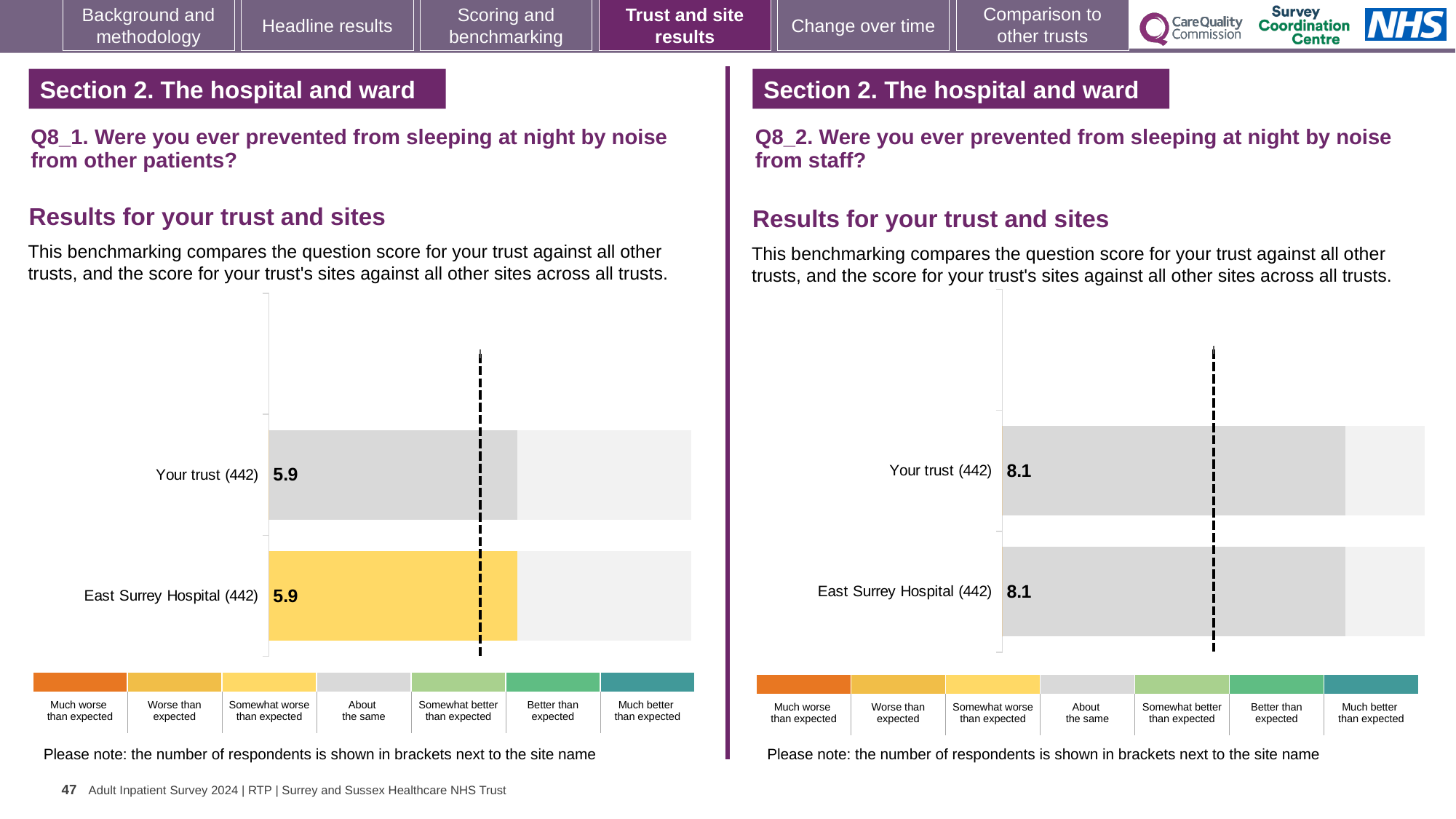
How many respondents are shown in brackets for Your trust on the Q8_2 chart (right)? 442 On the Q8_2 chart (right), what is the score for Your trust (442)? 8.1 On the Q8_1 chart (left), what colour is the bar for East Surrey Hospital (442)? Yellow What kind of chart is the Q8_1 chart on the left? Bar chart On the Q8_1 chart (left), what is the score for East Surrey Hospital (442)? 5.9 On the Q8_2 chart (right), how many bars are plotted? 2 On the Q8_2 chart (right), what is the difference between the score for Your trust and the score for East Surrey Hospital? 0.0 On the Q8_1 chart (left), what is the difference between the score for Your trust and the score for East Surrey Hospital? 0.0 On the Q8_2 chart (right), which benchmark category does the colour of the East Surrey Hospital bar correspond to? About the same On the Q8_1 chart (left), how many bars are plotted? 2 On the Q8_2 chart (right), what is the score for East Surrey Hospital (442)? 8.1 On the Q8_1 chart (left), what is the score for Your trust (442)? 5.9